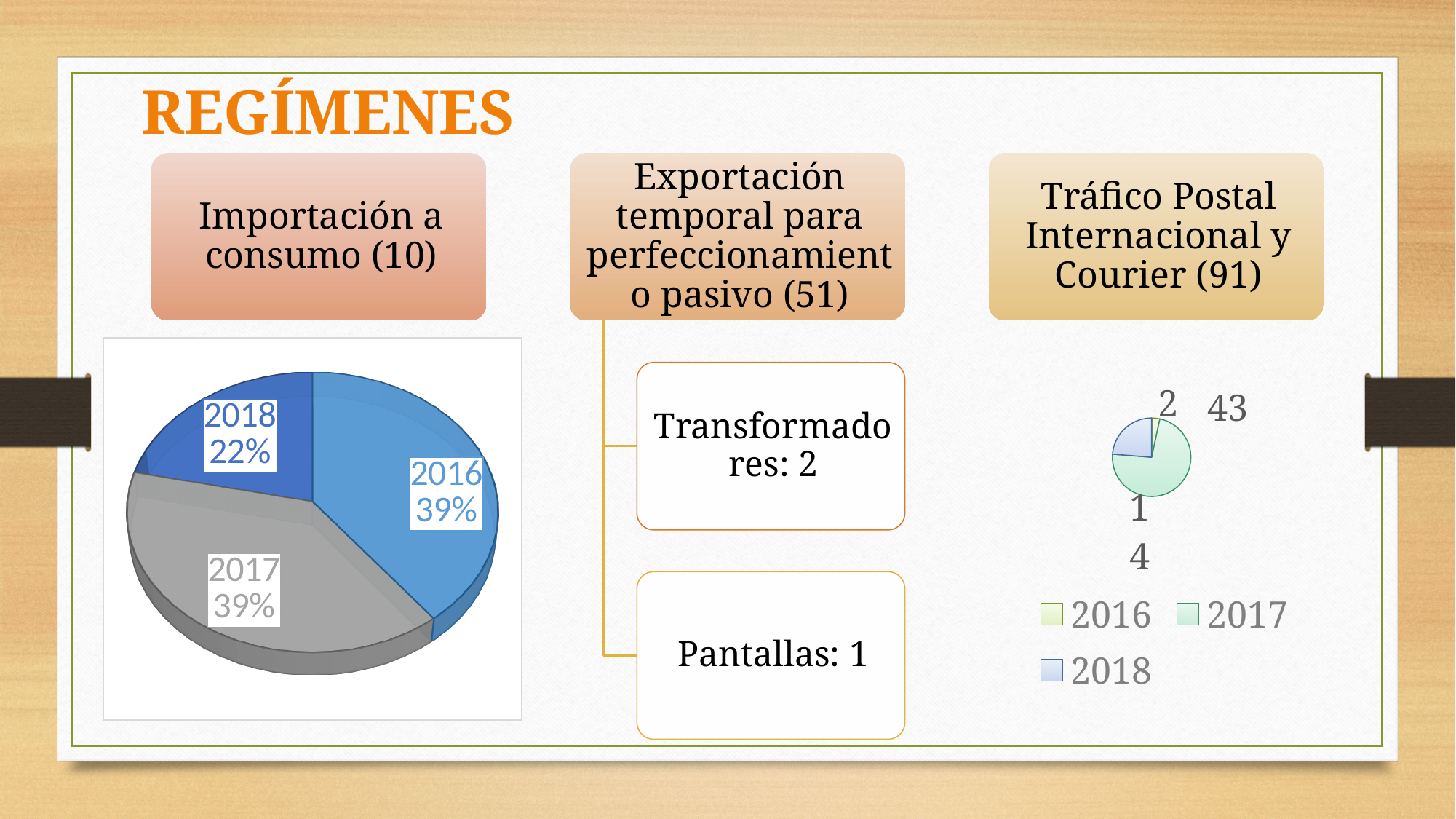
In the 'Tráfico Postal Internacional y Courier (91)' pie chart, which year has the smallest slice? 2016 How many slices does the 'Importación a consumo (10)' pie chart have? 3 In the 'Importación a consumo (10)' pie chart, how many percentage points larger is the 2016 share than the 2018 share? 17 percentage points In the 'Tráfico Postal Internacional y Courier (91)' pie chart, which year has the largest slice? 2017 In the 'Importación a consumo (10)' pie chart, what share does 2017 have? 39% In the 'Importación a consumo (10)' pie chart, which year has the smallest slice? 2018 In the 'Tráfico Postal Internacional y Courier (91)' pie chart, what is the value for 2017? 43 In the 'Importación a consumo (10)' pie chart, what share does 2018 have? 22% In the 'Importación a consumo (10)' pie chart, what share does 2016 have? 39% How many entries does the legend of the 'Tráfico Postal Internacional y Courier (91)' chart list? 3 What kind of chart is shown under the 'Importación a consumo (10)' heading? Pie chart What kind of chart is shown under the 'Tráfico Postal Internacional y Courier (91)' heading? Pie chart